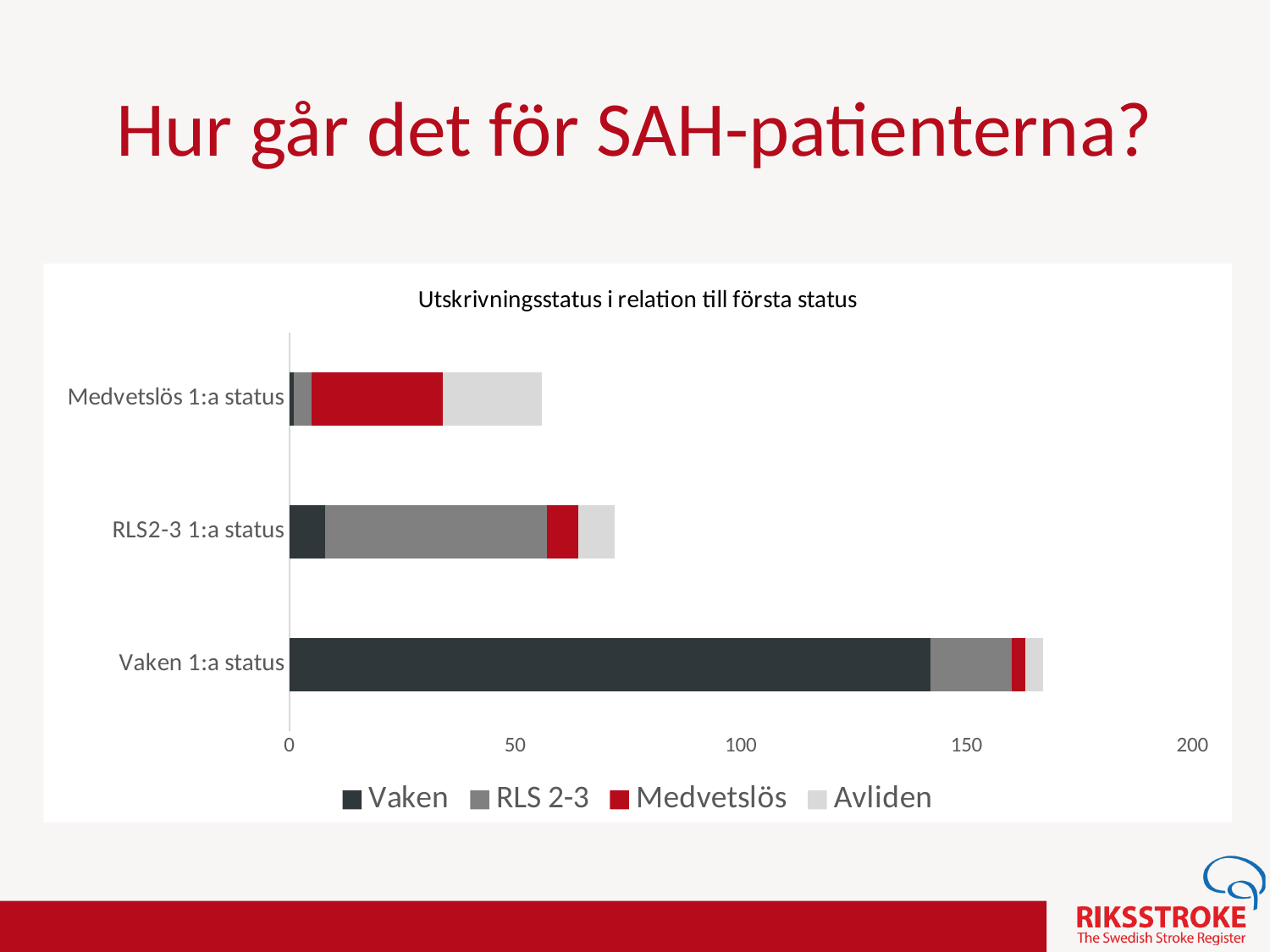
Which series forms the largest segment of the Medvetslös 1:a status bar? Medvetslös What is the title of the chart? Utskrivningsstatus i relation till första status Which category has the shortest total bar? Medvetslös 1:a status How many categories are shown on the vertical axis of the chart? 3 Which total bar is longer, RLS2-3 1:a status or Medvetslös 1:a status? RLS2-3 1:a status Which category has the longest total bar? Vaken 1:a status How many series does the legend list? 4 Is the total bar length for Medvetslös 1:a status greater or less than 50? greater Is the Vaken segment of the Vaken 1:a status bar greater or less than 100? greater Is the total bar length for RLS2-3 1:a status greater or less than 100? less What kind of chart is shown on the slide? Stacked bar chart